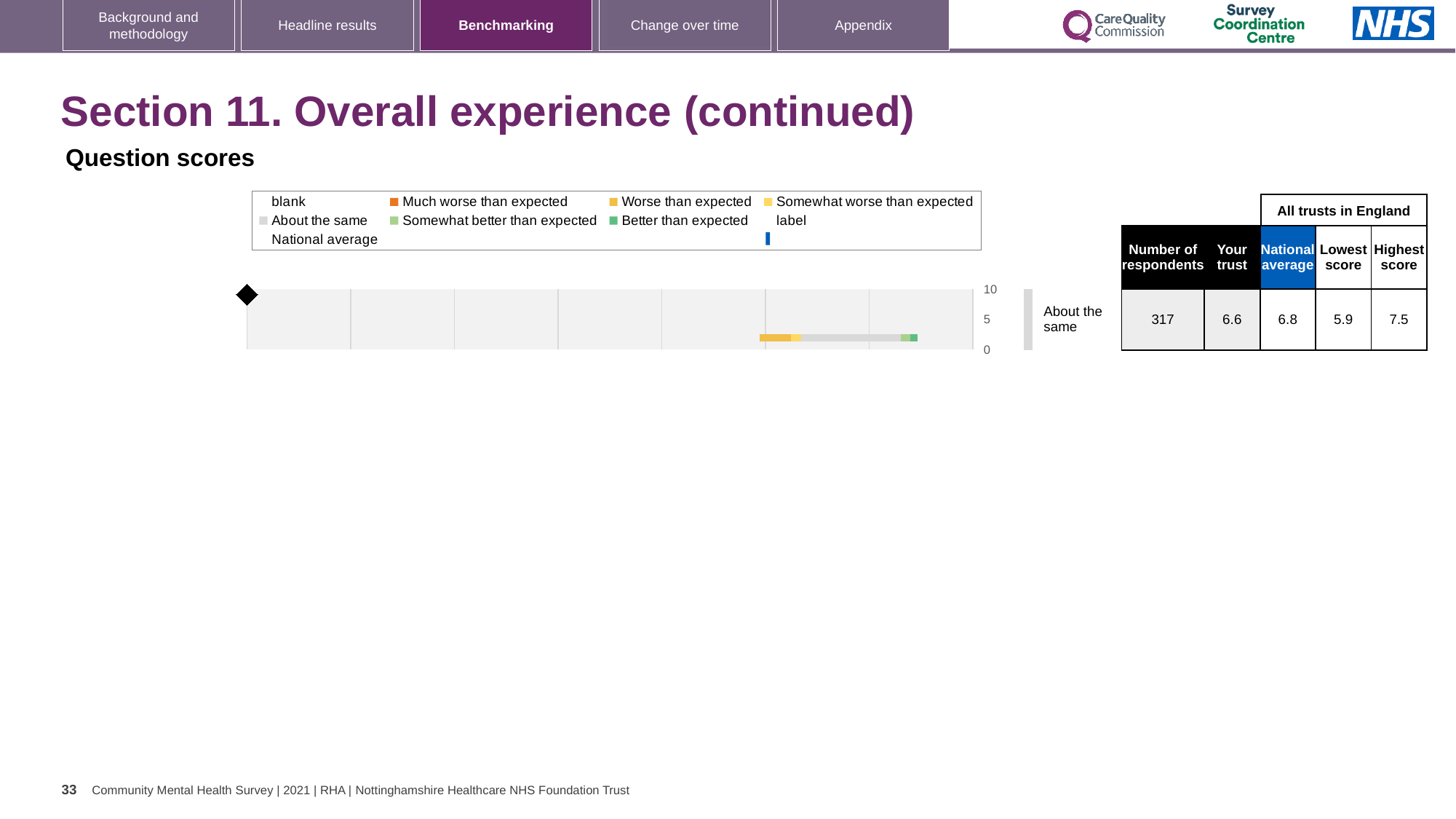
What kind of chart is shown under 'Question scores'? bar chart What is the national average score shown for the 'About the same' question? 6.8 How many question bars are plotted in the chart? 1 Is the 'Your trust' score for this question greater or less than 5? greater What is the highest value shown on the chart's vertical axis? 10 Which is larger for this question: the 'Your trust' score or the national average? National average How many respondents answered the 'About the same' question? 317 What is the highest score among all trusts in England for this question? 7.5 By how much does the national average exceed the 'Your trust' score? 0.2 What is the lowest score among all trusts in England for this question? 5.9 What is the difference between the highest score and the lowest score for this question? 1.6 What is the 'Your trust' score for the question rated 'About the same'? 6.6